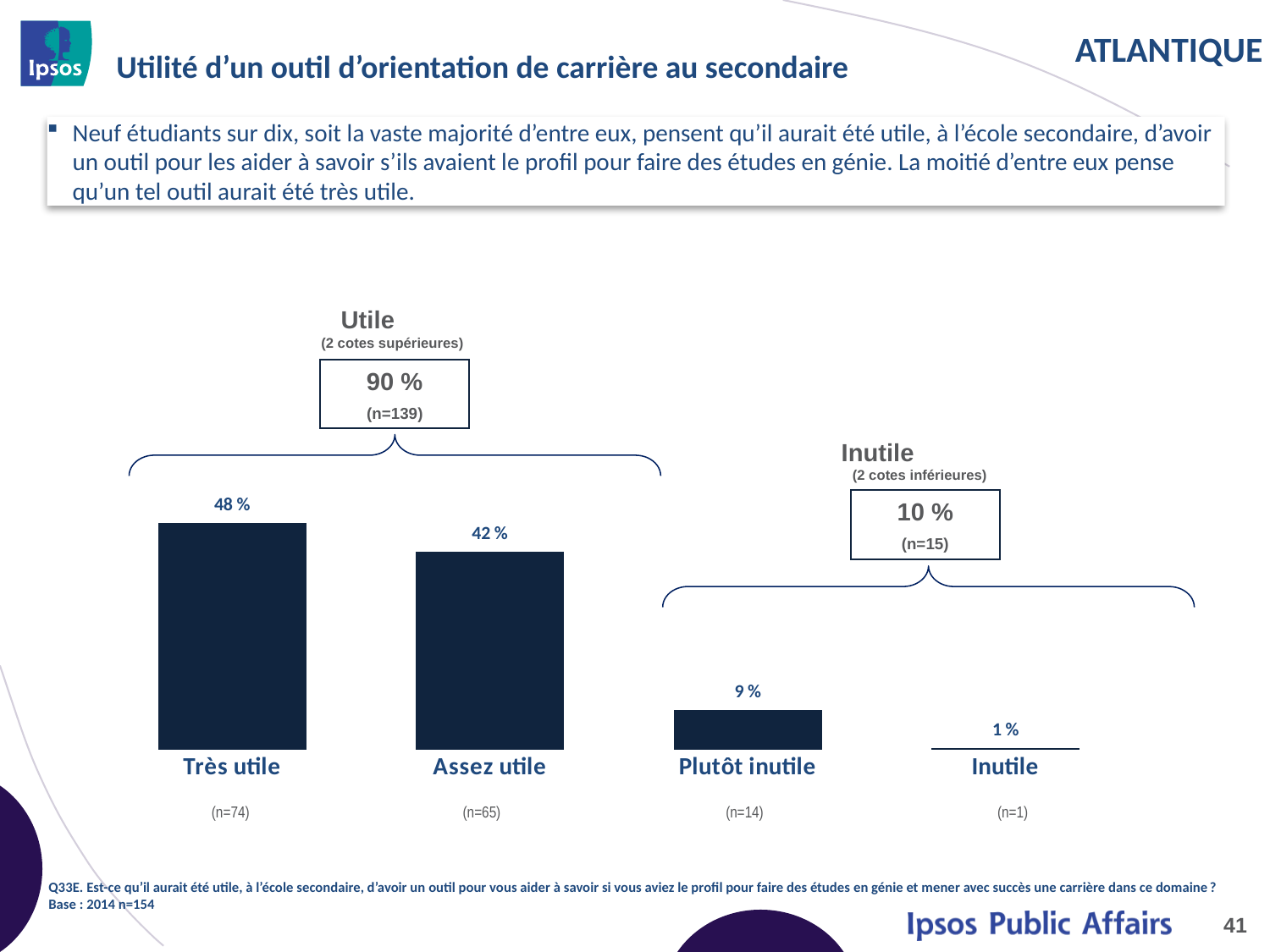
What is the sample size (n) shown under "Très utile"? n=74 How many categories are shown in the chart? 4 What is the value for "Assez utile"? 42 % What is the value for "Très utile"? 48 % Which category has the lowest value? Inutile Which category has the highest value? Très utile What combined percentage is shown in the "Utile (2 cotes supérieures)" box? 90 % What is the value for "Inutile"? 1 % What is the value for "Plutôt inutile"? 9 % Which is larger, the value for "Assez utile" or the value for "Plutôt inutile"? Assez utile What kind of chart is shown on the slide? Bar chart What is the difference between the values for "Très utile" and "Assez utile"? 6 %